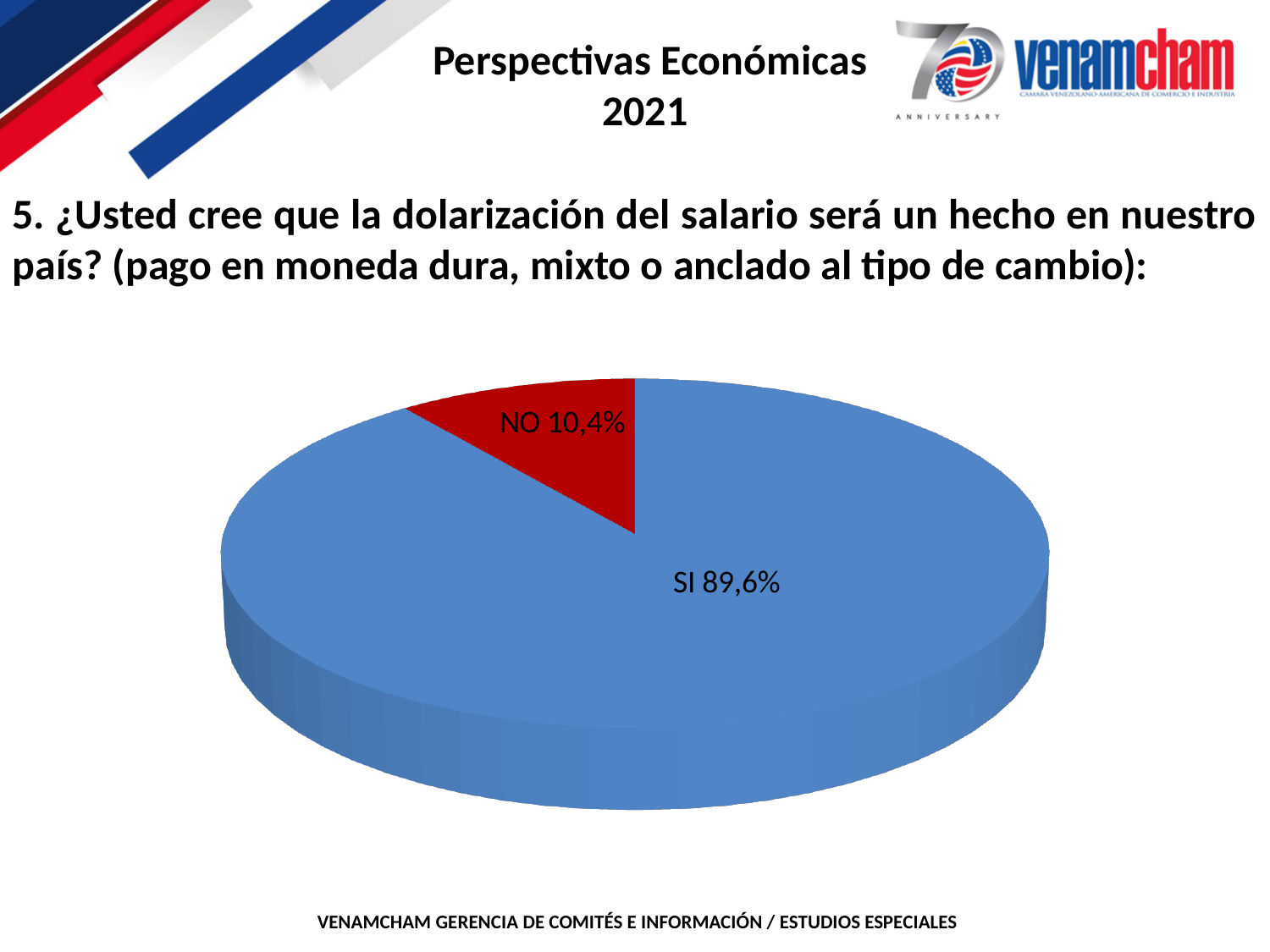
What share of the pie does the NO slice represent? 10,4% How many slices does the pie chart have? 2 Which response has the largest share of the pie? SI What colour is the SI slice of the pie chart? Blue What is the difference in percentage points between the SI and NO responses? 79,2 Which response is larger, SI or NO? SI Which response has the smallest share of the pie? NO What colour is the NO slice of the pie chart? Red What kind of chart is shown on the slide? Pie chart What percentage of respondents answered NO? 10,4% What percentage of respondents answered SI? 89,6%